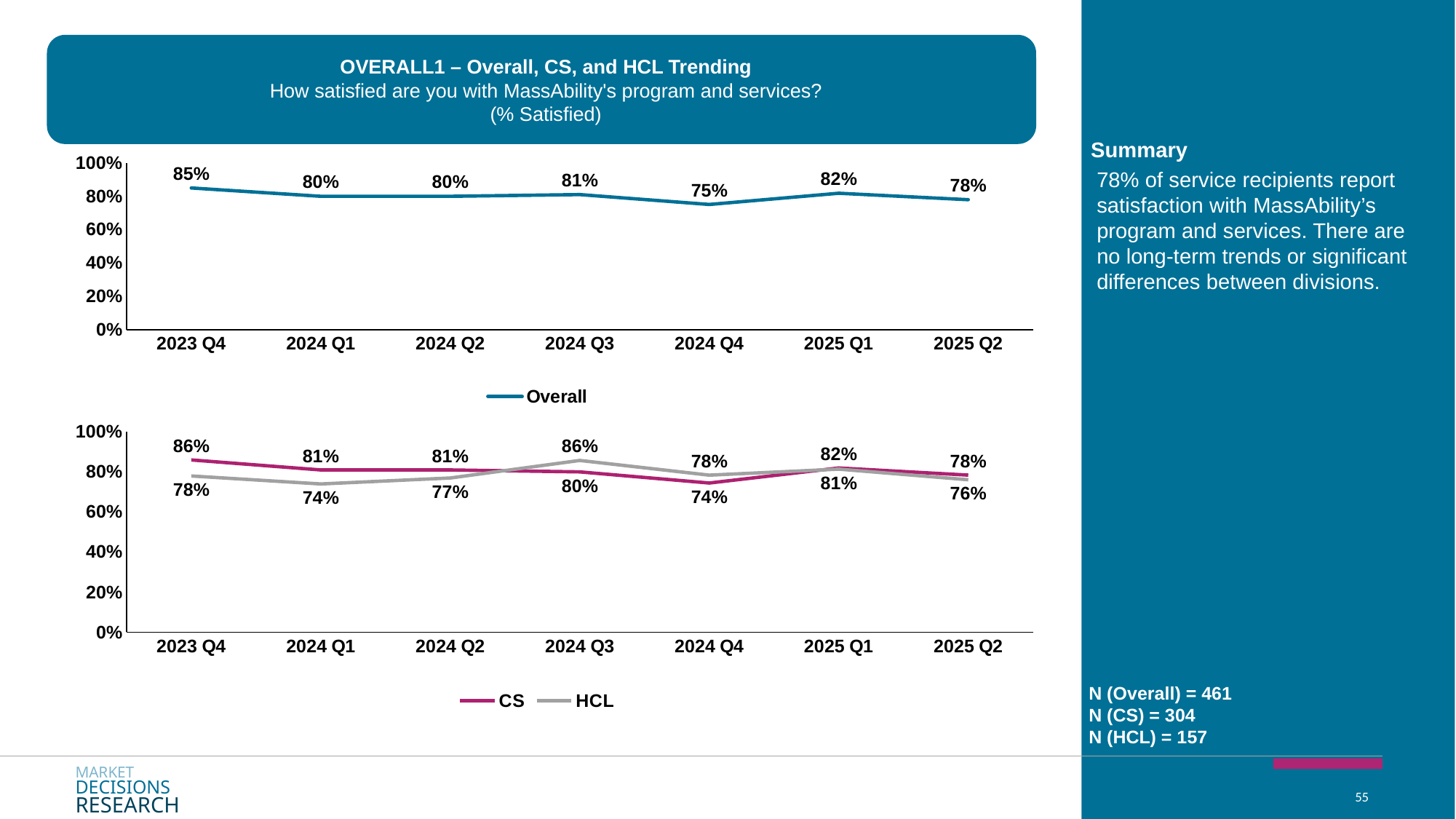
In the bottom chart (CS and HCL), what is the CS value for 2024 Q4? 74% In the top chart (Overall), how many quarters are plotted? 7 In the top chart (Overall), which quarter has the highest value? 2023 Q4 In the top chart (Overall), what is the difference between the 2025 Q1 value and the 2025 Q2 value? 4 percentage points In the bottom chart (CS and HCL), what is the HCL value for 2024 Q3? 86% In the bottom chart (CS and HCL), which series has the higher value in 2024 Q1, CS or HCL? CS In the bottom chart (CS and HCL), how many series does the legend list? 2 In the bottom chart (CS and HCL), what is the difference between the HCL value and the CS value in 2024 Q3? 6 percentage points What type of chart is the bottom chart (CS and HCL)? Line chart In the top chart (Overall), which quarter has the lowest value? 2024 Q4 In the top chart (Overall), what is the value for 2024 Q4? 75% In the top chart (Overall), what is the value for 2023 Q4? 85%